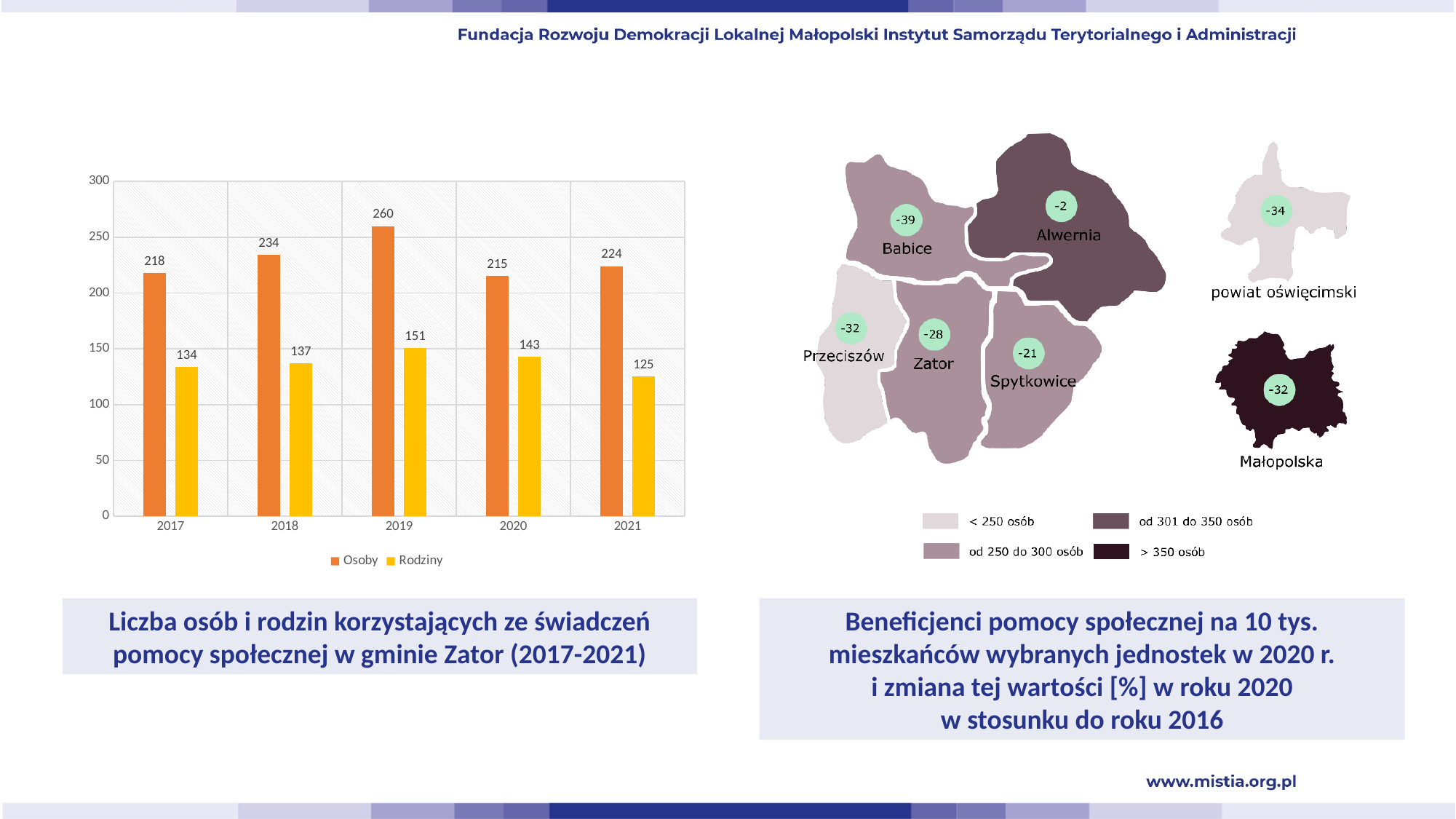
What type of chart is shown on the left side of the slide? bar chart In the bar chart on the left, which year has the highest value for Osoby? 2019 In the bar chart on the left, what is the value for Rodziny in 2021? 125 In the bar chart on the left, what is the value for Osoby in 2019? 260 In the bar chart on the left, do the Rodziny values rise or fall from 2019 to 2021? fall In the bar chart on the left, which year has the larger value for Osoby: 2018 or 2021? 2018 In the bar chart on the left, which year has the lowest value for Rodziny? 2021 On the map on the right, what is the change value shown for Zator? -28 In the bar chart on the left, how many series does the legend list? 2 In the bar chart on the left, what is the difference between Osoby and Rodziny in 2019? 109 On the map on the right, what is the change value shown for Babice? -39 In the bar chart on the left, how many years are shown on the x axis? 5